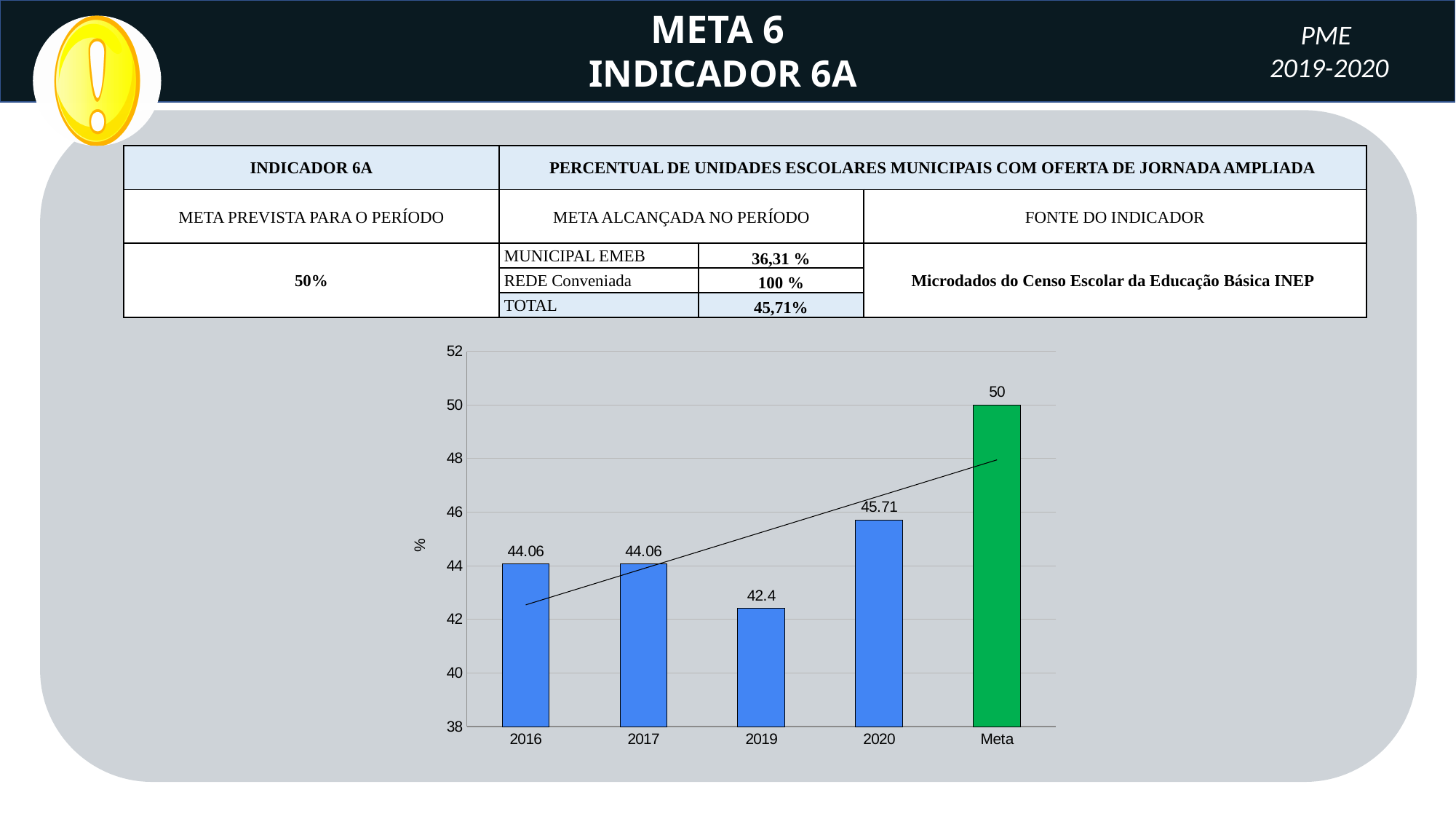
What is the label on the vertical axis of the chart? % What kind of chart is shown on the slide? bar chart How many bars are shown in the chart? 5 What is the value for 2019 in the chart? 42.4 What is the value for 2016 in the chart? 44.06 Which category has the lowest bar in the chart? 2019 Which is larger, the value for 2017 or the value for 2019? 2017 What is the difference between the 2020 value and the 2019 value? 3.31 What is the value for 2020 in the chart? 45.71 What is the difference between the Meta value and the 2020 value? 4.29 What is the value for the Meta bar in the chart? 50 Which category has the highest bar in the chart? Meta